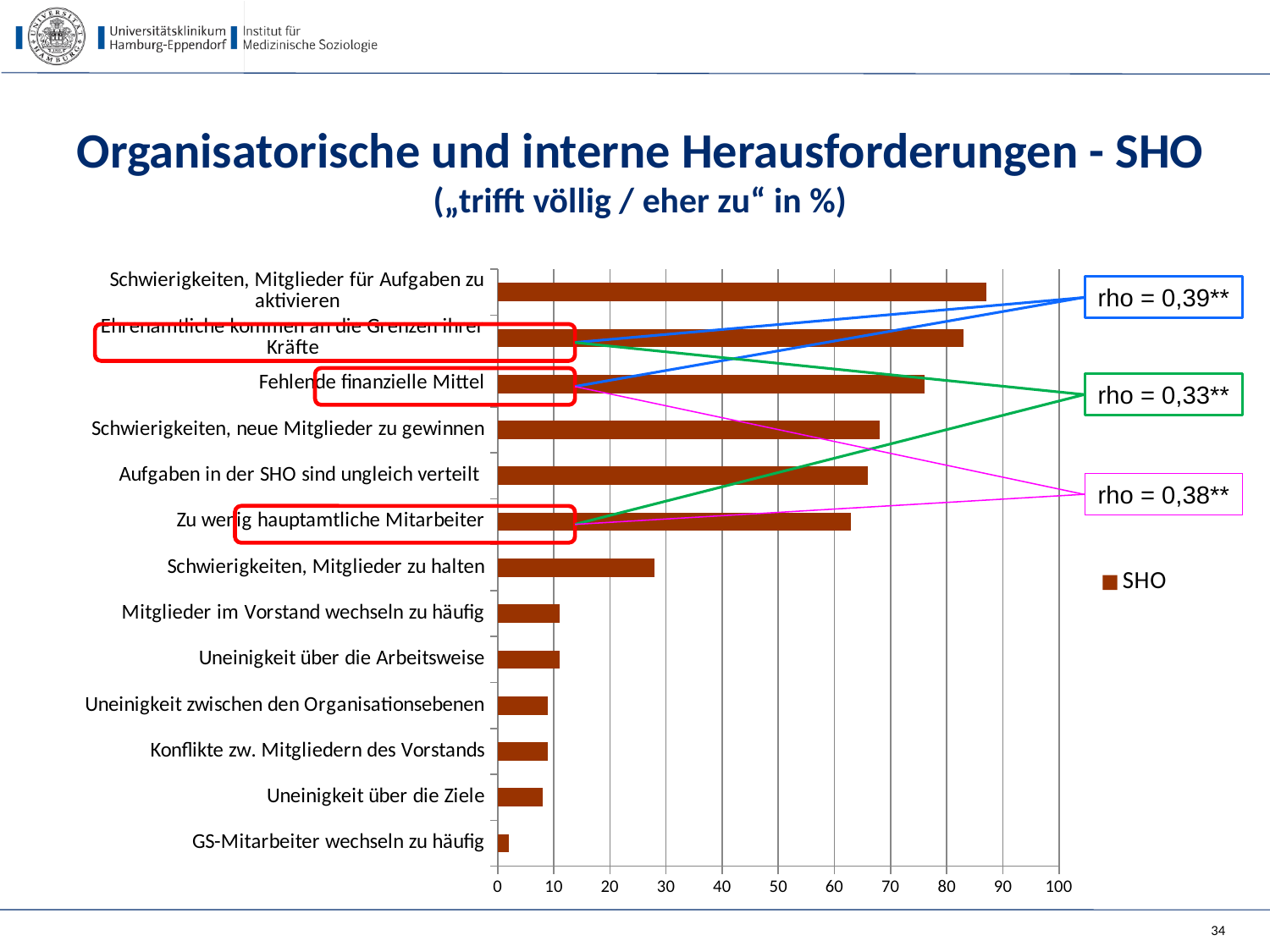
What kind of chart is shown on the slide? bar chart Which category has the highest value? Schwierigkeiten, Mitglieder für Aufgaben zu aktivieren What is the name of the series shown in the legend? SHO Which is larger: the value for Fehlende finanzielle Mittel or the value for Zu wenig hauptamtliche Mitarbeiter? Fehlende finanzielle Mittel Is the value for Fehlende finanzielle Mittel greater or less than 70? greater Is the value for Schwierigkeiten, Mitglieder zu halten greater or less than 40? less How many series does the legend list? 1 Is the value for Schwierigkeiten, neue Mitglieder zu gewinnen greater or less than 60? greater How many categories are plotted in the chart? 13 Which category has the lowest value? GS-Mitarbeiter wechseln zu häufig Do the bar values rise or fall going from the top category to the bottom category? fall